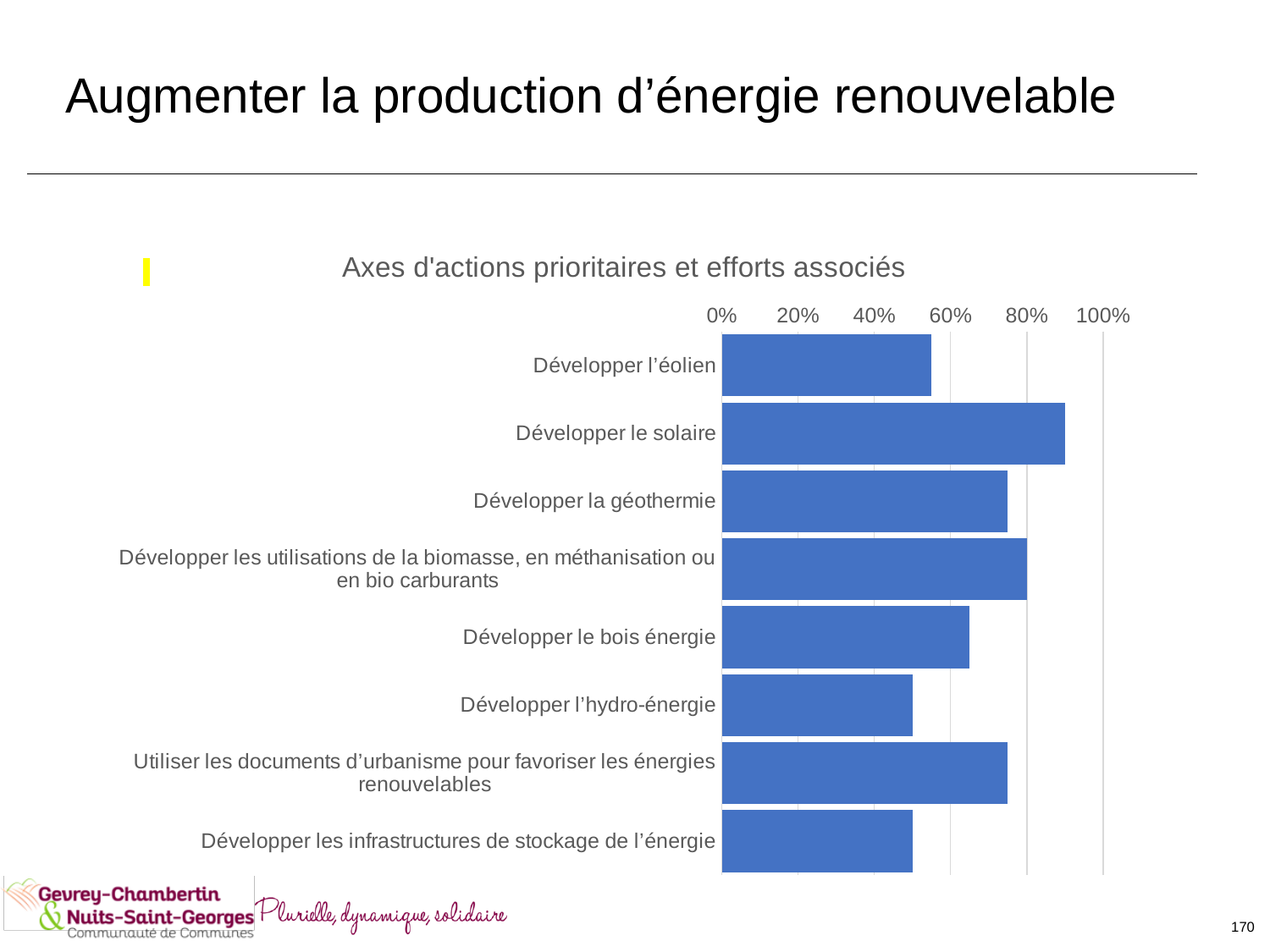
How many categories (bars) does the chart show? 8 What kind of chart is shown on the slide? bar chart Which is larger: the value for "Développer la géothermie" or the value for "Développer l’hydro-énergie"? Développer la géothermie Is the value for "Développer l’hydro-énergie" greater or less than 60%? less Is the value for "Développer le solaire" greater or less than 80%? greater Is the value for "Développer l’éolien" greater or less than 60%? less Which is larger: the value for "Développer le solaire" or the value for "Développer l’éolien"? Développer le solaire Which category has the highest value? Développer le solaire What is the title of the chart? Axes d'actions prioritaires et efforts associés